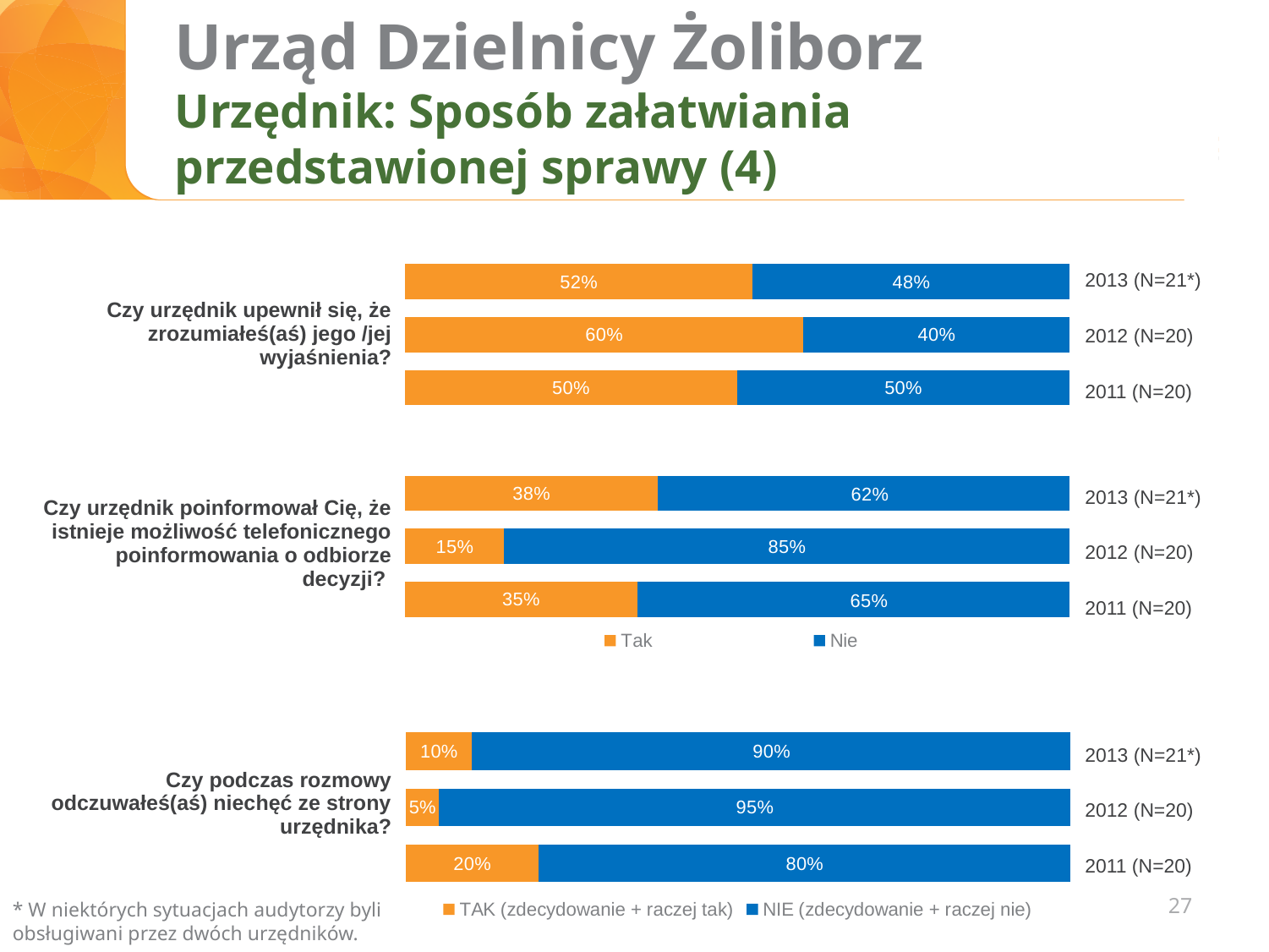
In the middle chart ("Czy urzędnik poinformował Cię, że istnieje możliwość telefonicznego poinformowania o odbiorze decyzji?"), what is the Nie value for 2012 (N=20)? 85% In the top chart ("Czy urzędnik upewnił się, że zrozumiałeś(aś) jego /jej wyjaśnienia?"), which year has the highest Tak share? 2012 (N=20) In the middle chart ("Czy urzędnik poinformował Cię, że istnieje możliwość telefonicznego poinformowania o odbiorze decyzji?"), which year has the lowest Tak share? 2012 (N=20) In the middle chart ("Czy urzędnik poinformował Cię, że istnieje możliwość telefonicznego poinformowania o odbiorze decyzji?"), what is the difference between the Tak values for 2013 (N=21*) and 2011 (N=20)? 3 percentage points In the bottom chart ("Czy podczas rozmowy odczuwałeś(aś) niechęć ze strony urzędnika?"), what is the TAK value for 2011 (N=20)? 20% In the top chart ("Czy urzędnik upewnił się, że zrozumiałeś(aś) jego /jej wyjaśnienia?"), what is the Tak value for 2013 (N=21*)? 52% What type of chart is used for the bottom chart ("Czy podczas rozmowy odczuwałeś(aś) niechęć ze strony urzędnika?")? Stacked bar chart How many series does the legend of the bottom chart ("Czy podczas rozmowy odczuwałeś(aś) niechęć ze strony urzędnika?") list? 2 In the top chart ("Czy urzędnik upewnił się, że zrozumiałeś(aś) jego /jej wyjaśnienia?"), what is the Nie value for 2012 (N=20)? 40% In the bottom chart ("Czy podczas rozmowy odczuwałeś(aś) niechęć ze strony urzędnika?"), is the TAK value for 2013 (N=21*) larger or smaller than the TAK value for 2011 (N=20)? smaller How many year categories does the top chart ("Czy urzędnik upewnił się, że zrozumiałeś(aś) jego /jej wyjaśnienia?") show? 3 In the bottom chart ("Czy podczas rozmowy odczuwałeś(aś) niechęć ze strony urzędnika?"), which year has the highest NIE share? 2012 (N=20)